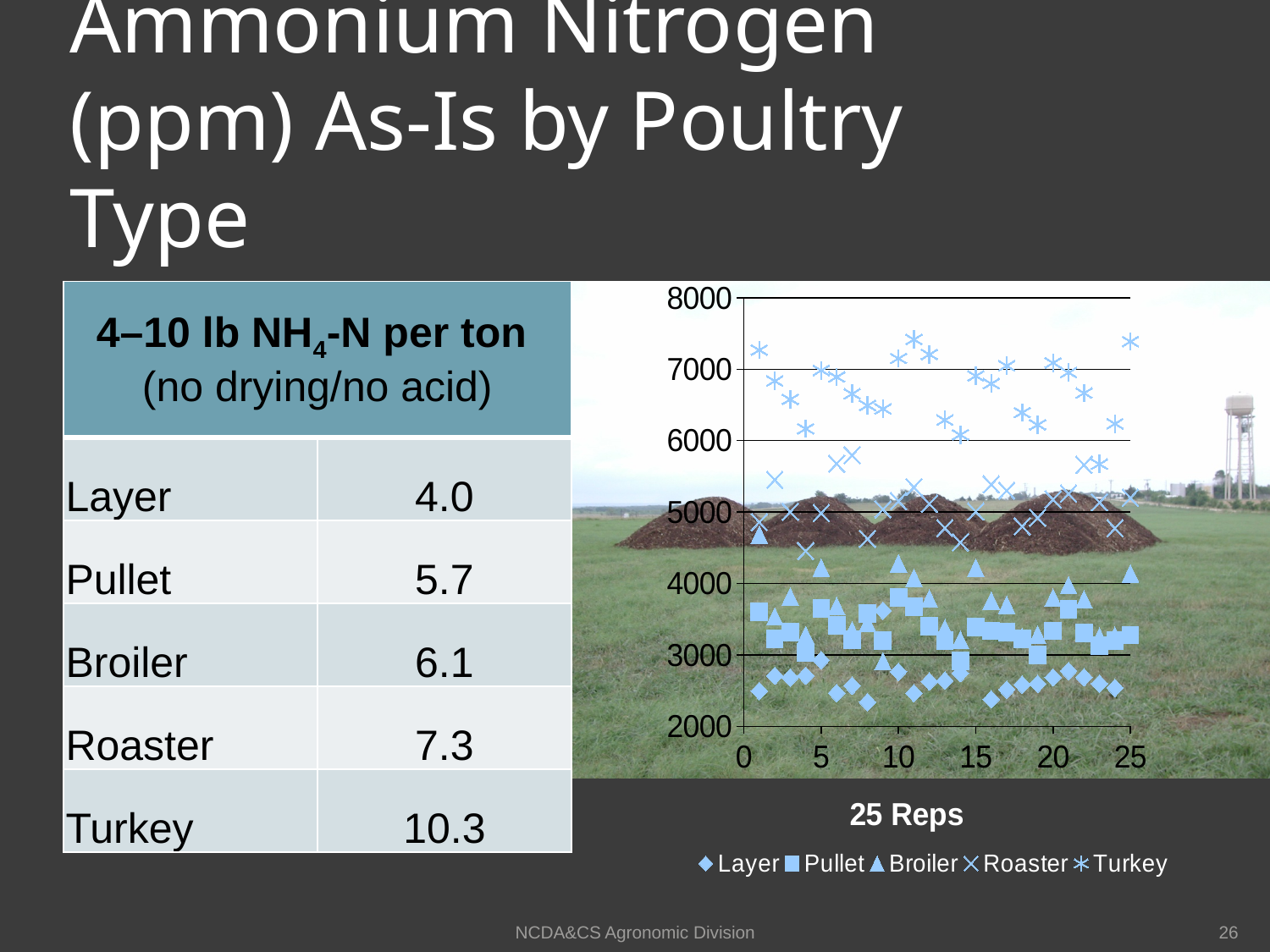
Which series has larger values in the chart, Roaster or Broiler? Roaster Are the Turkey values in the chart greater or less than 5000? greater How many series does the chart legend list? 5 Which series are listed in the chart legend? Layer, Pullet, Broiler, Roaster, Turkey What is the maximum value shown on the chart's y axis? 8000 Are the Roaster values in the chart greater or less than 4000? greater Are the Pullet values in the chart greater or less than 4000? less What kind of chart is shown on the slide? scatter chart What is the label under the x axis of the chart? 25 Reps Which series has the highest ammonium nitrogen values in the chart? Turkey Which series has the lowest ammonium nitrogen values in the chart? Layer